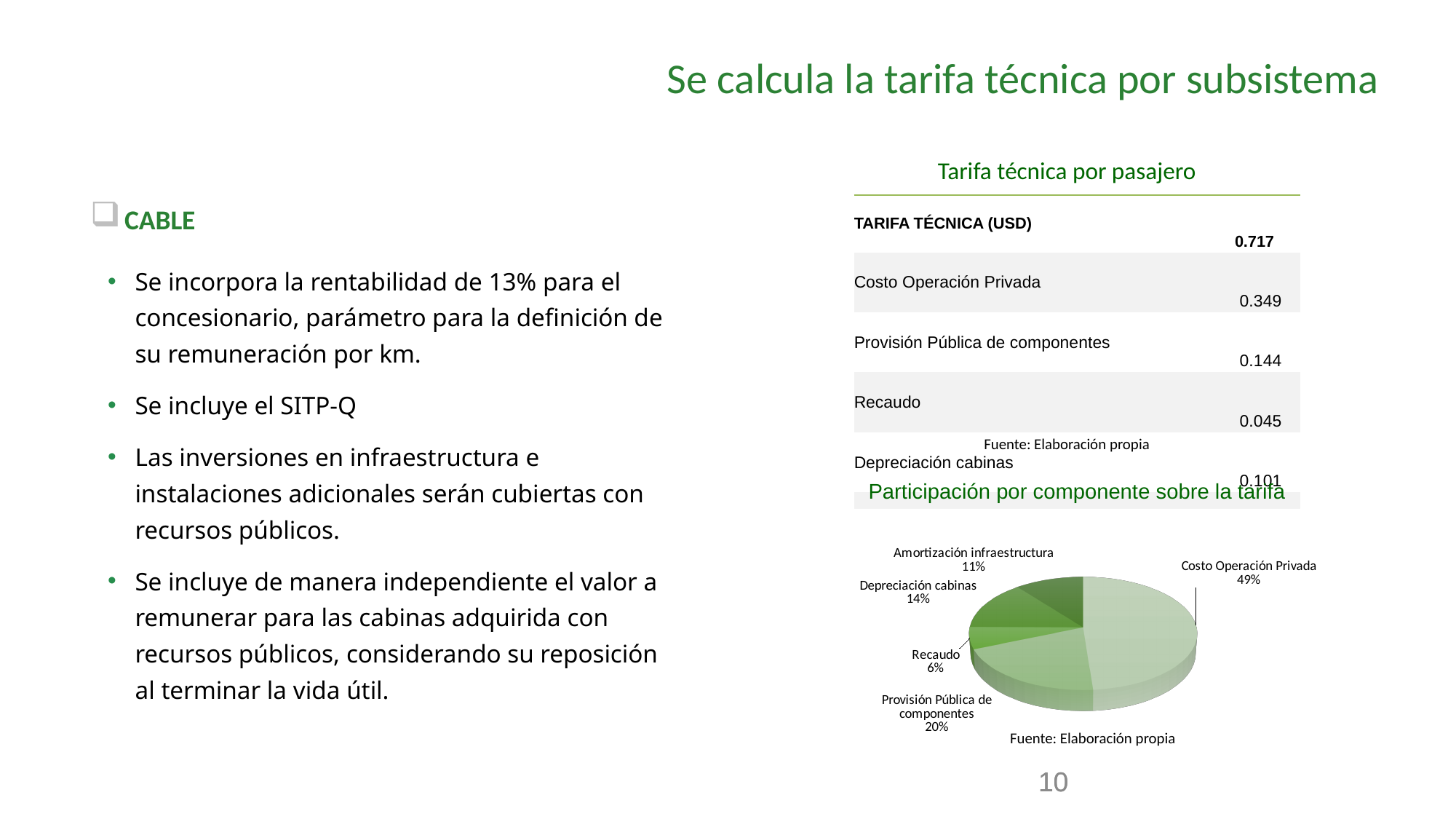
In the pie chart, what share does Depreciación cabinas have? 14% In the pie chart, what share does Amortización infraestructura have? 11% What kind of chart is shown under 'Participación por componente sobre la tarifa'? pie chart In the pie chart, what is the difference in percentage points between Costo Operación Privada and Provisión Pública de componentes? 29 In the pie chart, what share does Costo Operación Privada have? 49% Which component has the smallest slice in the pie chart? Recaudo What is the title of the pie chart? Participación por componente sobre la tarifa In the pie chart, which is larger: Depreciación cabinas or Amortización infraestructura? Depreciación cabinas How many slices does the pie chart have? 5 Which component has the largest slice in the pie chart? Costo Operación Privada